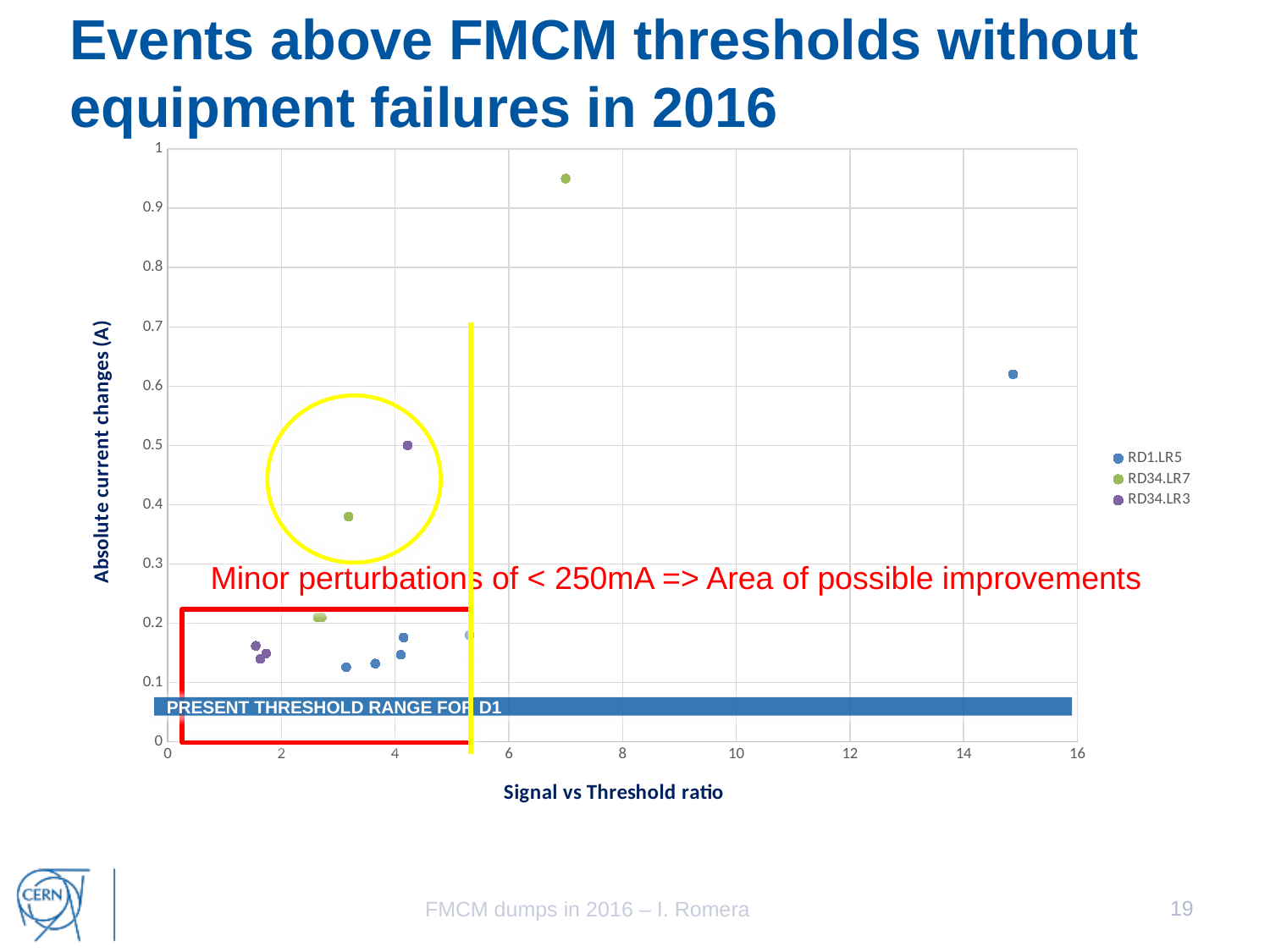
What is the title of the vertical axis of the chart? Absolute current changes (A) Which has the larger absolute current change: the highest RD34.LR7 point or the highest RD1.LR5 point? RD34.LR7 Is the absolute current change of the RD34.LR3 point inside the yellow circle greater or less than 0.4? greater What kind of chart is shown on the slide? Scatter chart Is the absolute current change of the rightmost point (RD1.LR5) greater or less than 0.5? greater Is the absolute current change of the highest point on the chart greater or less than 0.9? greater How many series does the chart legend list? 3 Which series contains the point with the highest absolute current change? RD34.LR7 What is the title of the horizontal axis of the chart? Signal vs Threshold ratio Which series contains the point with the largest signal vs threshold ratio? RD1.LR5